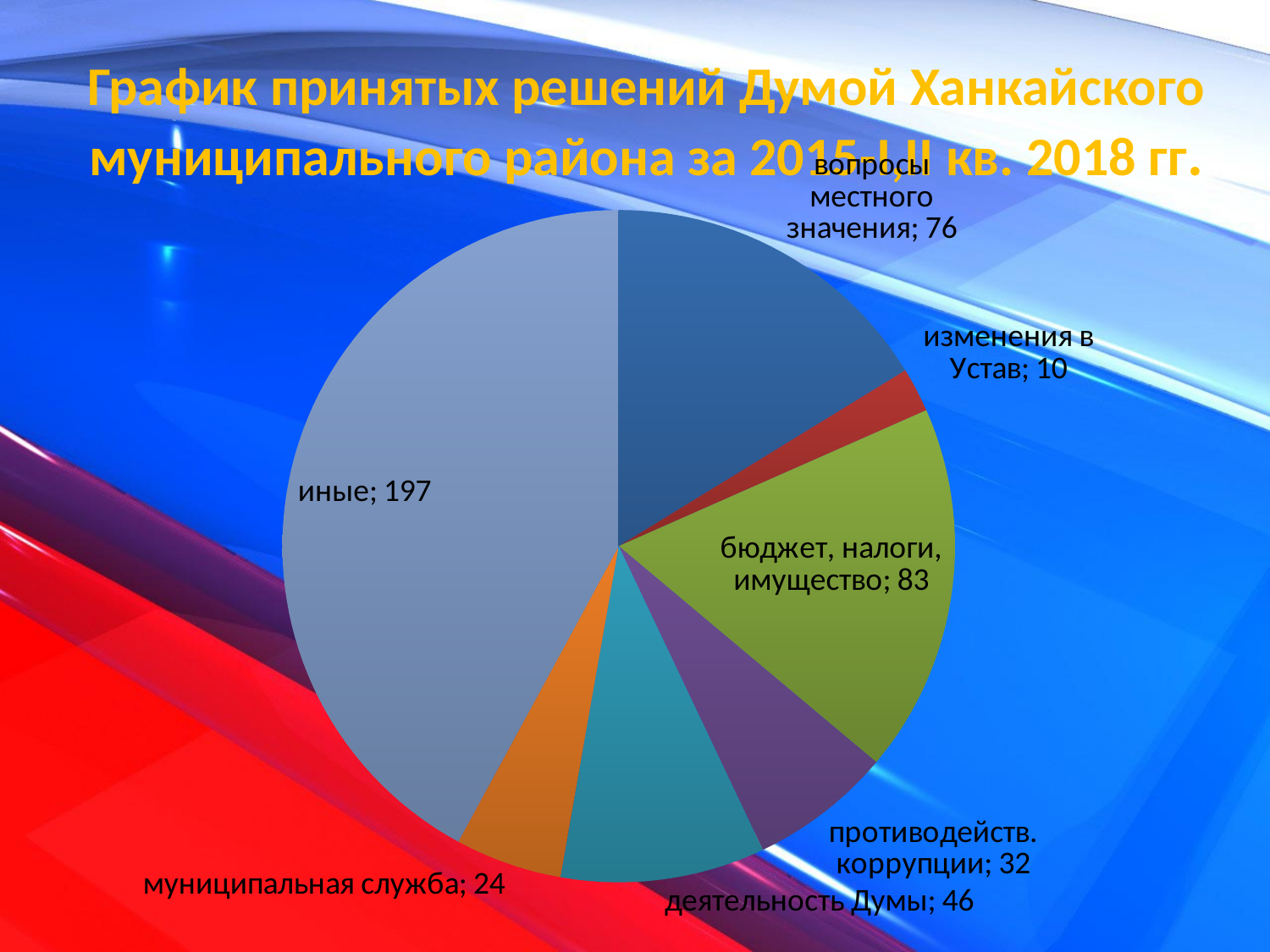
Which category has the largest slice? иные What is the value for "бюджет, налоги, имущество"? 83 What kind of chart is shown on the slide? pie chart What is the total of all slices in the pie chart? 468 Which is larger, "муниципальная служба" or "деятельность Думы"? деятельность Думы Which category has the smallest slice? изменения в Устав What is the difference between "иные" and "бюджет, налоги, имущество"? 114 How many slices does the pie chart have? 7 What is the value for "деятельность Думы"? 46 What is the value for "изменения в Устав"? 10 What is the value for "иные"? 197 What is the difference between "вопросы местного значения" and "противодейств. коррупции"? 44